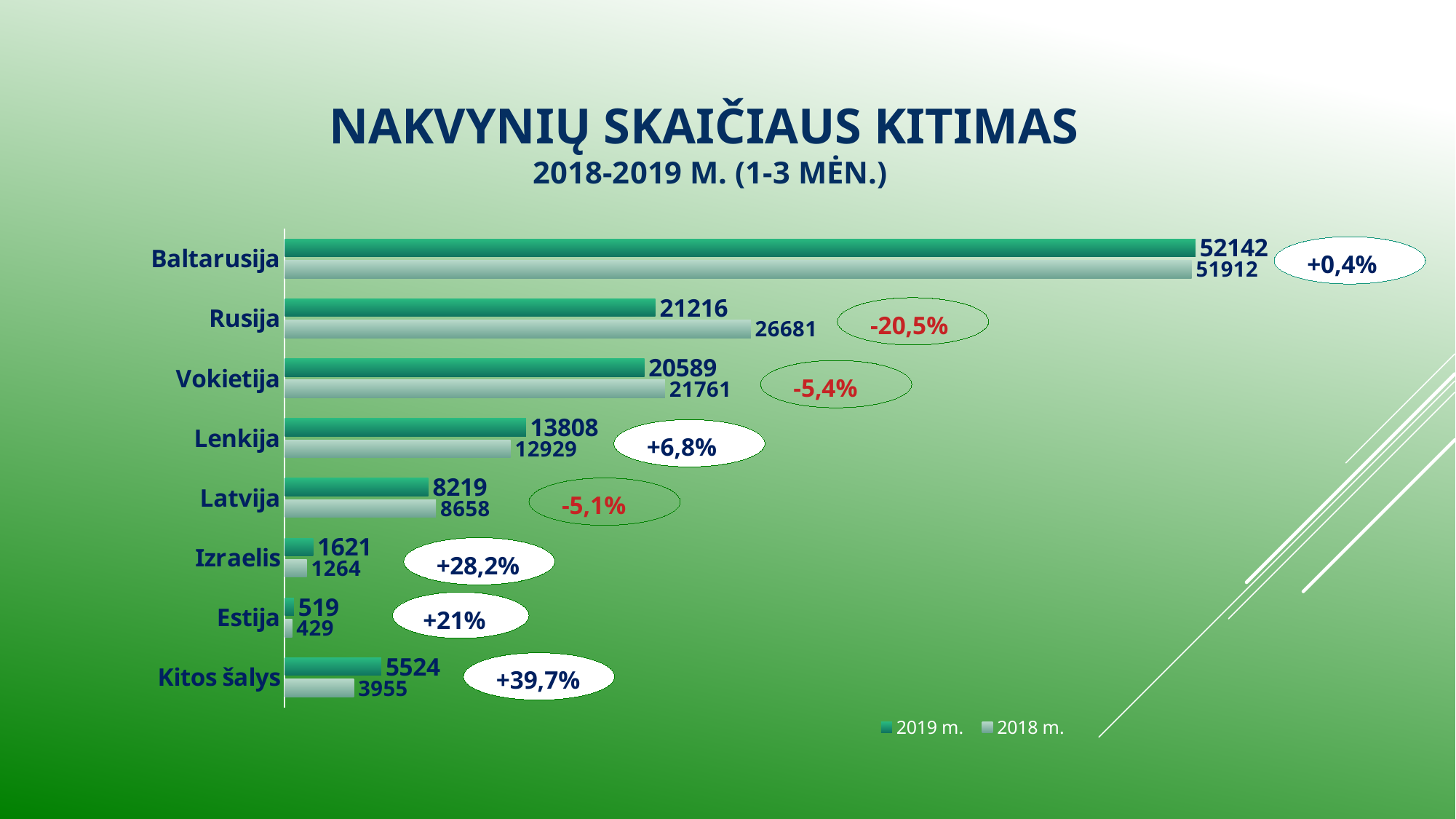
What kind of chart is shown on the slide? bar chart Which is larger for Latvija, the 2019 m. value or the 2018 m. value? 2018 m. How many categories are shown on the chart? 8 How many series does the legend list? 2 What percentage change is shown next to Izraelis? +28,2% What is the 2019 m. value for Rusija? 21216 What is the difference between the 2018 m. and 2019 m. values for Rusija? 5465 What is the difference between the 2019 m. and 2018 m. values for Lenkija? 879 Which category has the highest 2019 m. value? Baltarusija Which category has the lowest 2018 m. value? Estija What is the 2018 m. value for Vokietija? 21761 What is the 2019 m. value for Kitos šalys? 5524